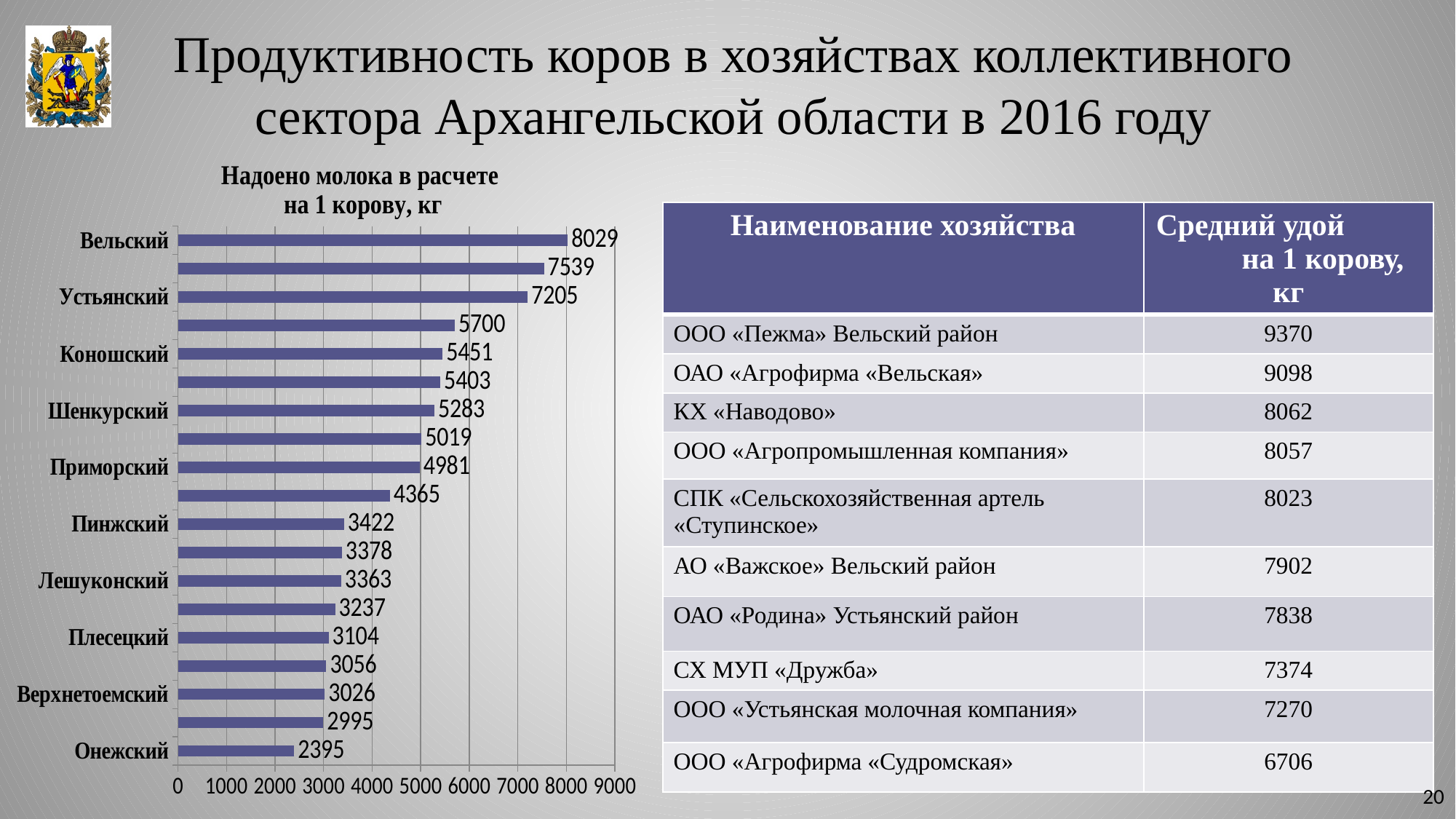
How many bars are plotted in the chart? 19 What kind of chart is shown on the slide? bar chart What is the value for Онежский in the chart? 2395 Which category has the lowest value in the chart? Онежский What is the difference between the values for Вельский and Устьянский? 824 What is the chart's title? Надоено молока в расчете на 1 корову, кг Which has the larger value, Коношский or Шенкурский? Коношский What is the value for Устьянский in the chart? 7205 What is the value for Приморский in the chart? 4981 Is the value for Пинежский greater or less than 4000? less Which category has the highest value in the chart? Вельский What is the value for Вельский in the chart? 8029